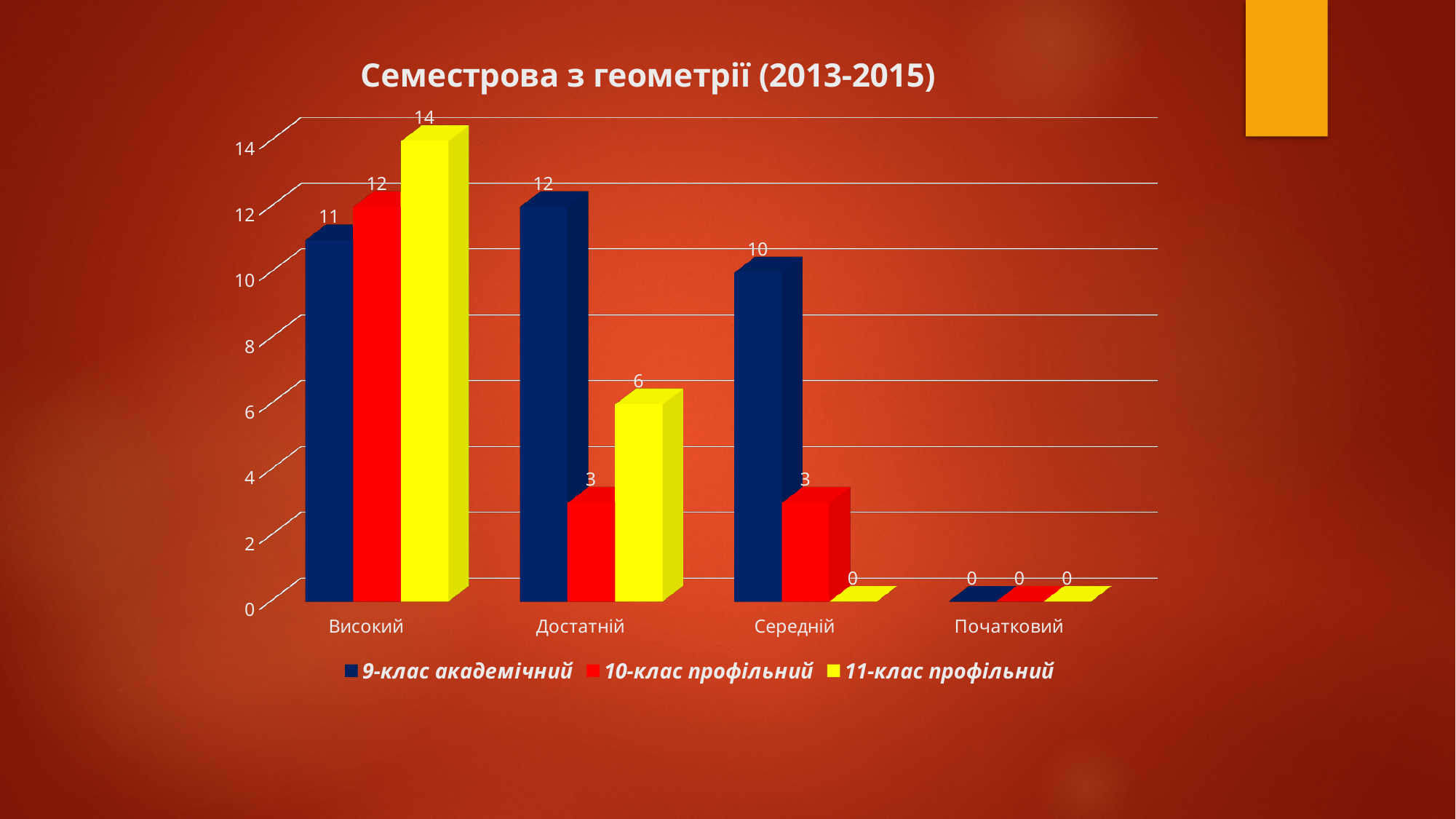
What is the value for 10-клас профільний in the Достатній category? 3 Which category has the highest value for 9-клас академічний? Достатній How many series does the legend list? 3 What is the difference between the 11-клас профільний and 9-клас академічний values in the Високий category? 3 Which category has the lowest value for 11-клас профільний other than Початковий? Середній How many categories are shown on the x axis? 4 What kind of chart is shown on the slide? Bar chart What is the value for 11-клас профільний in the Високий category? 14 What is the value for 11-клас профільний in the Середній category? 0 In the Достатній category, which is larger: 9-клас академічний or 11-клас профільний? 9-клас академічний What is the value for 9-клас академічний in the Середній category? 10 What is the title of the chart? Семестрова з геометрії (2013-2015)